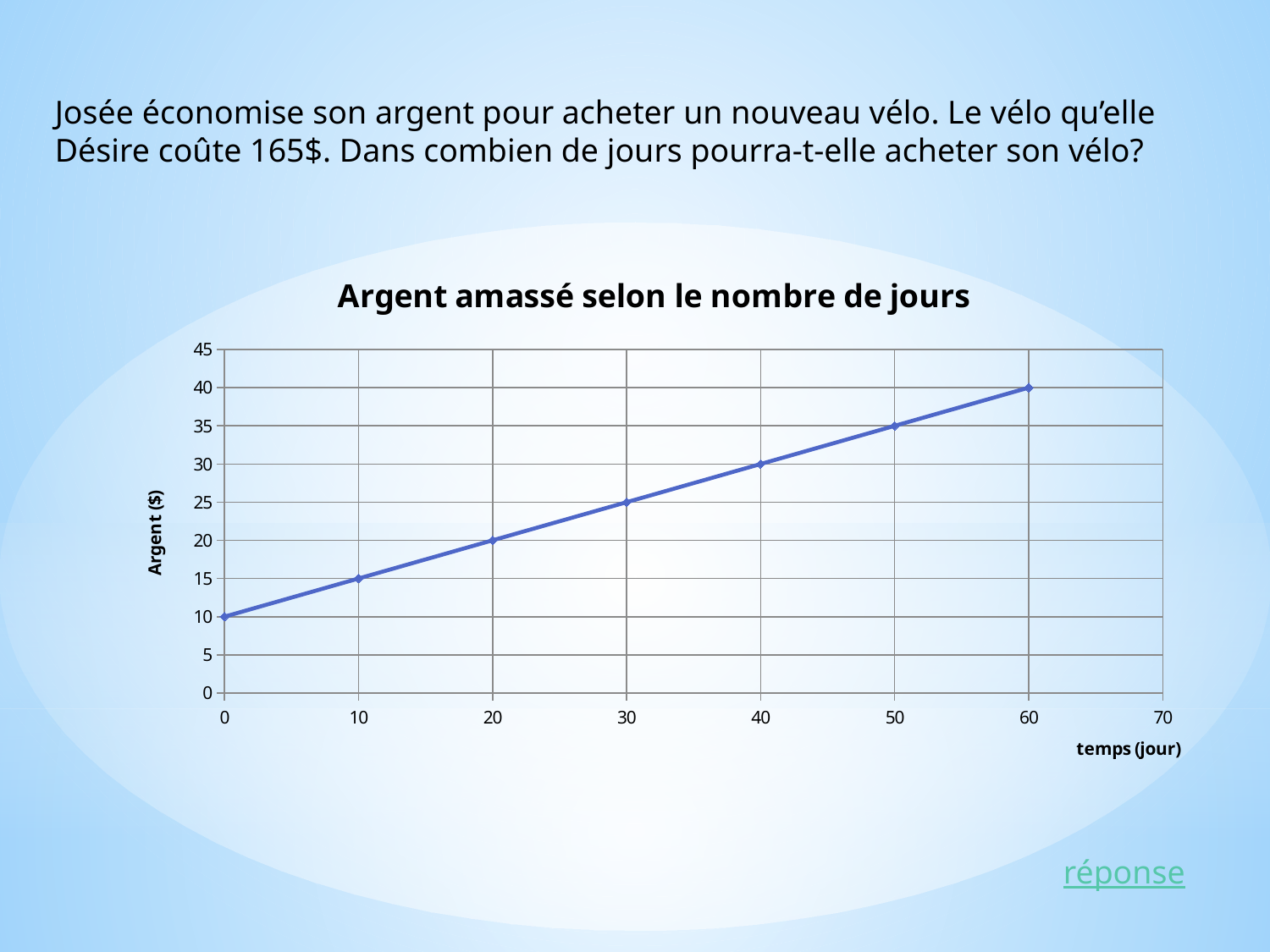
At which number of days is the amount of money highest? 60 Do the values rise or fall as the number of days increases? rise What is the title of the chart? Argent amassé selon le nombre de jours What is the difference in Argent ($) between 60 days and 0 days? 30 What is the value of Argent ($) at 0 days (temps = 0)? 10 What is the value of Argent ($) at 60 days? 40 What kind of chart is shown on the slide? line chart What is the value of Argent ($) at 30 days? 25 Is the value at 40 days greater or less than 25? greater At which number of days is the amount of money lowest? 0 How many data points are plotted on the line? 7 What is the label of the vertical axis? Argent ($)